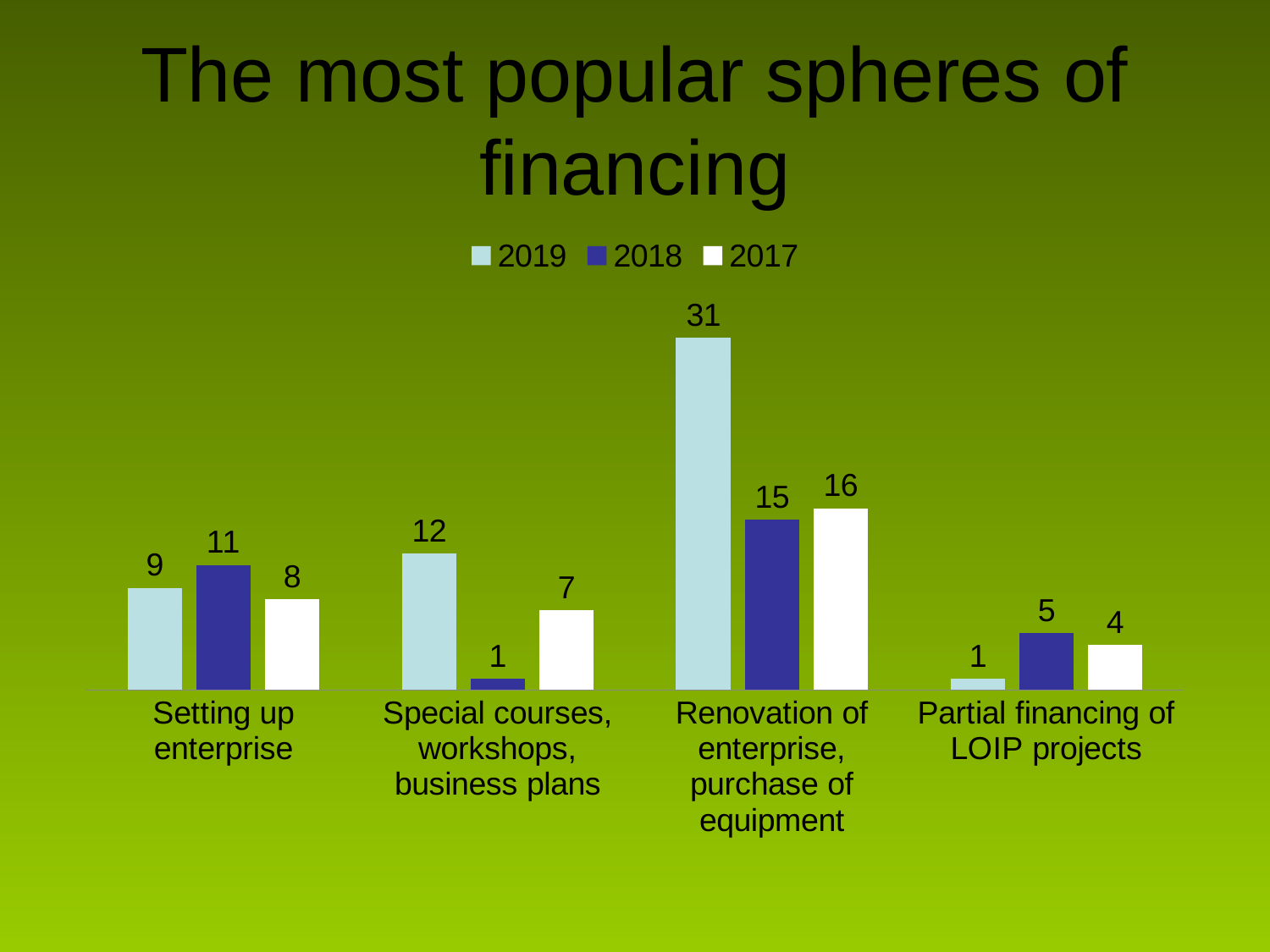
How many categories are shown on the x axis? 4 What kind of chart is shown on the slide? Bar chart What is the 2018 value for Special courses, workshops, business plans? 1 For Setting up enterprise, which year has the larger value, 2018 or 2017? 2018 What is the difference between the 2019 and 2017 values for Renovation of enterprise, purchase of equipment? 15 How many series does the legend list? 3 What is the 2017 value for Partial financing of LOIP projects? 4 What is the 2019 value for Renovation of enterprise, purchase of equipment? 31 What is the total of the three values for Partial financing of LOIP projects? 10 What is the title of the slide? The most popular spheres of financing Which category has the highest 2019 value? Renovation of enterprise, purchase of equipment Which category has the lowest 2018 value? Special courses, workshops, business plans